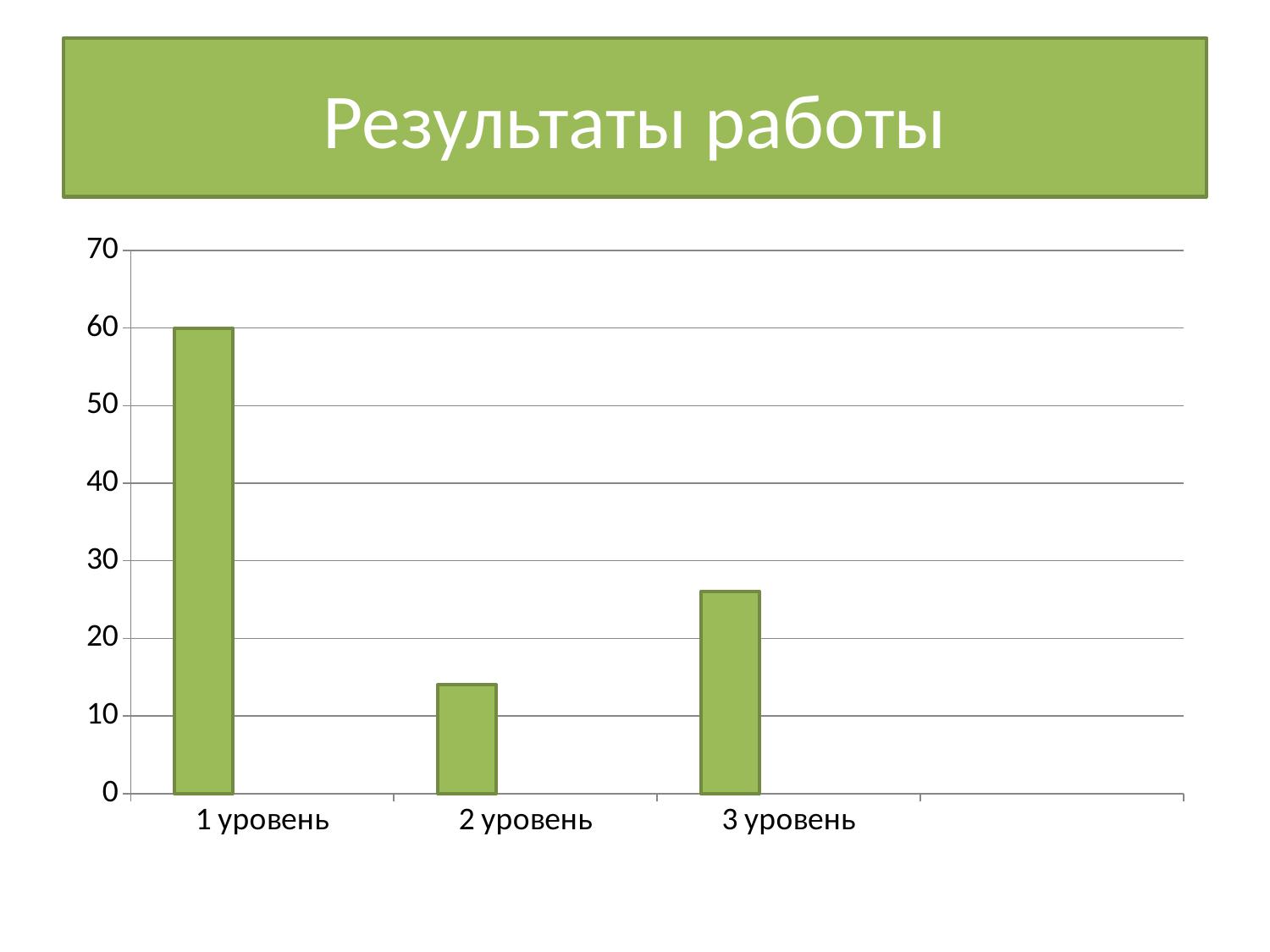
Is the value for 2 уровень greater or less than 20? less Which is larger, the value for 2 уровень or the value for 3 уровень? 3 уровень What kind of chart is shown on the slide? bar chart How many categories are plotted on the chart? 3 What is the value for 1 уровень? 60 Is the value for 2 уровень greater or less than 10? greater Is the value for 3 уровень greater or less than 20? greater What colour are the bars on the chart? green What is the title of the slide? Результаты работы Which category has the highest value? 1 уровень Which category has the lowest value? 2 уровень